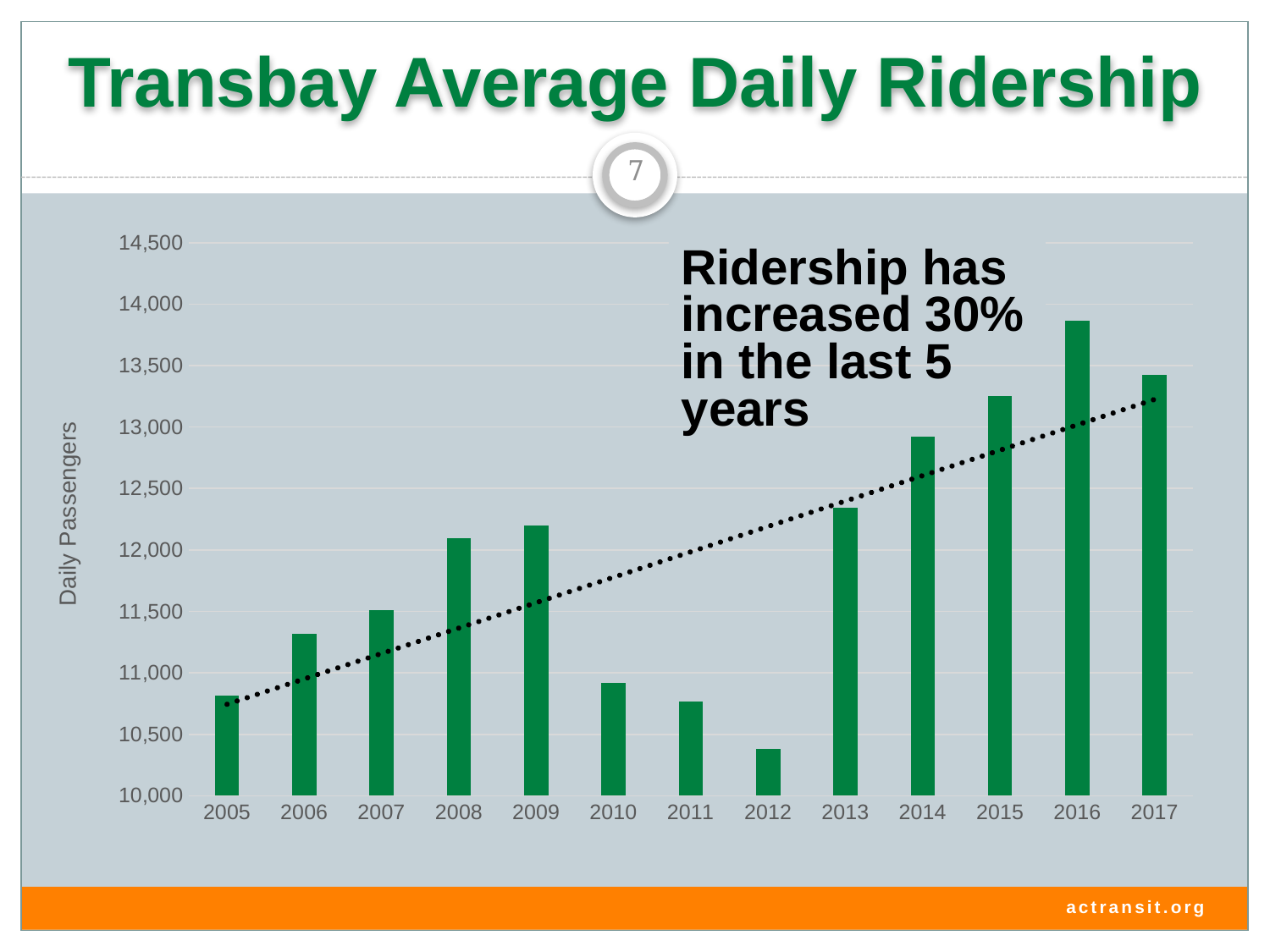
How many years are plotted on the x axis? 13 What is the label on the y axis? Daily Passengers Is the value for 2016 greater or less than 13,500? greater Which year has the higher ridership, 2013 or 2015? 2015 Which year has the higher ridership, 2009 or 2010? 2009 Is the value for 2014 greater or less than 12,500? greater Is the value for 2010 greater or less than 11,000? less What kind of chart is shown on the slide? bar chart According to the dotted trend line, do values generally rise or fall from 2005 to 2017? rise Which year has the highest average daily ridership? 2016 Which year has the lowest average daily ridership? 2012